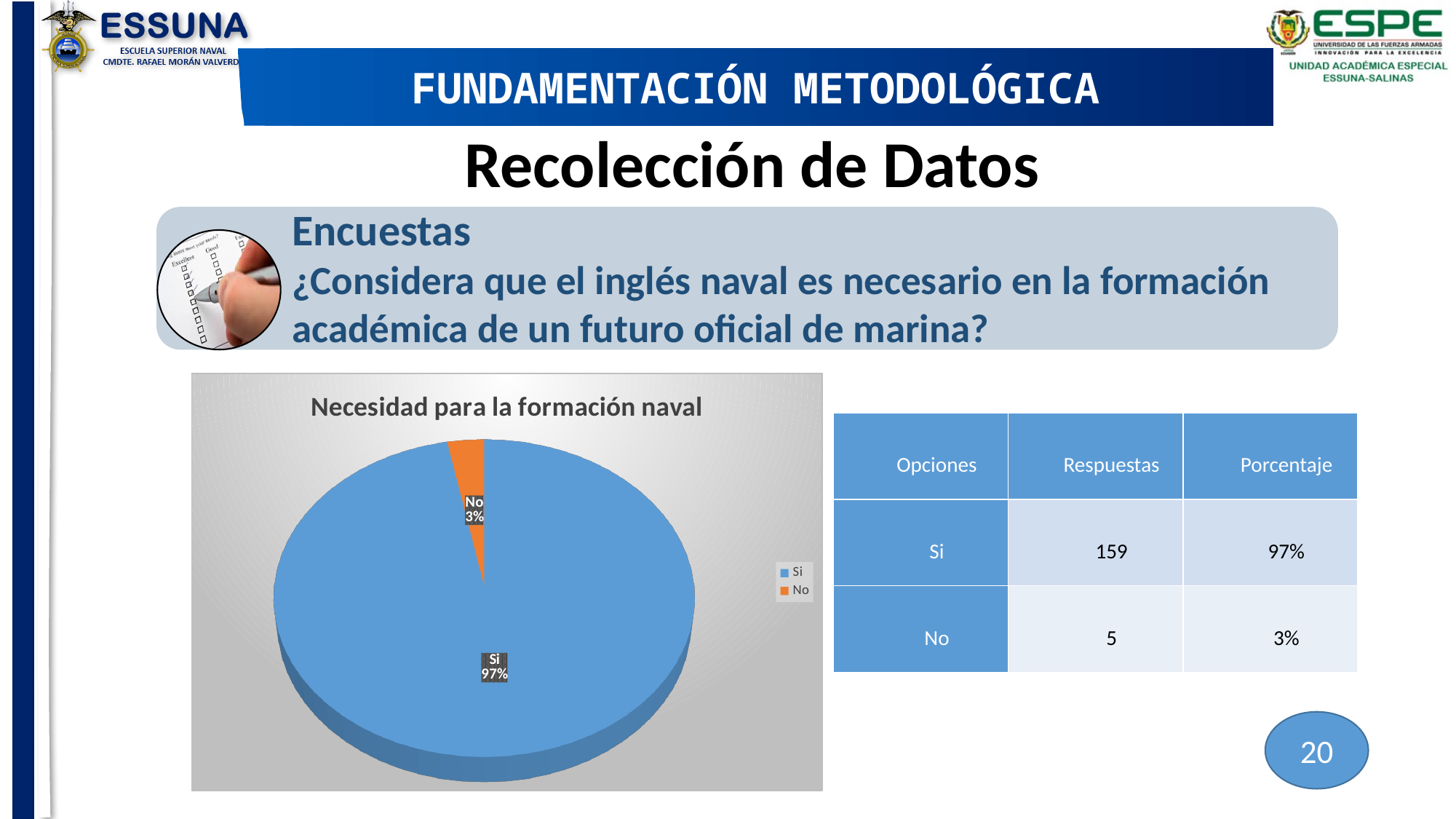
What colour is the 'No' slice in the pie chart? orange How many entries does the legend of the pie chart list? 2 What share of the pie does the 'Si' slice represent? 97% Which slice of the pie chart is the smallest? No How many slices does the pie chart have? 2 What type of chart is shown on the slide? pie chart Which slice of the pie chart is the largest? Si What percentage does the 'No' slice show in the pie chart? 3% What is the title of the pie chart? Necesidad para la formación naval Which is larger in the pie chart, the 'Si' slice or the 'No' slice? Si What is the difference in percentage points between the 'Si' and 'No' slices? 94 What percentage does the 'Si' slice show in the pie chart? 97%